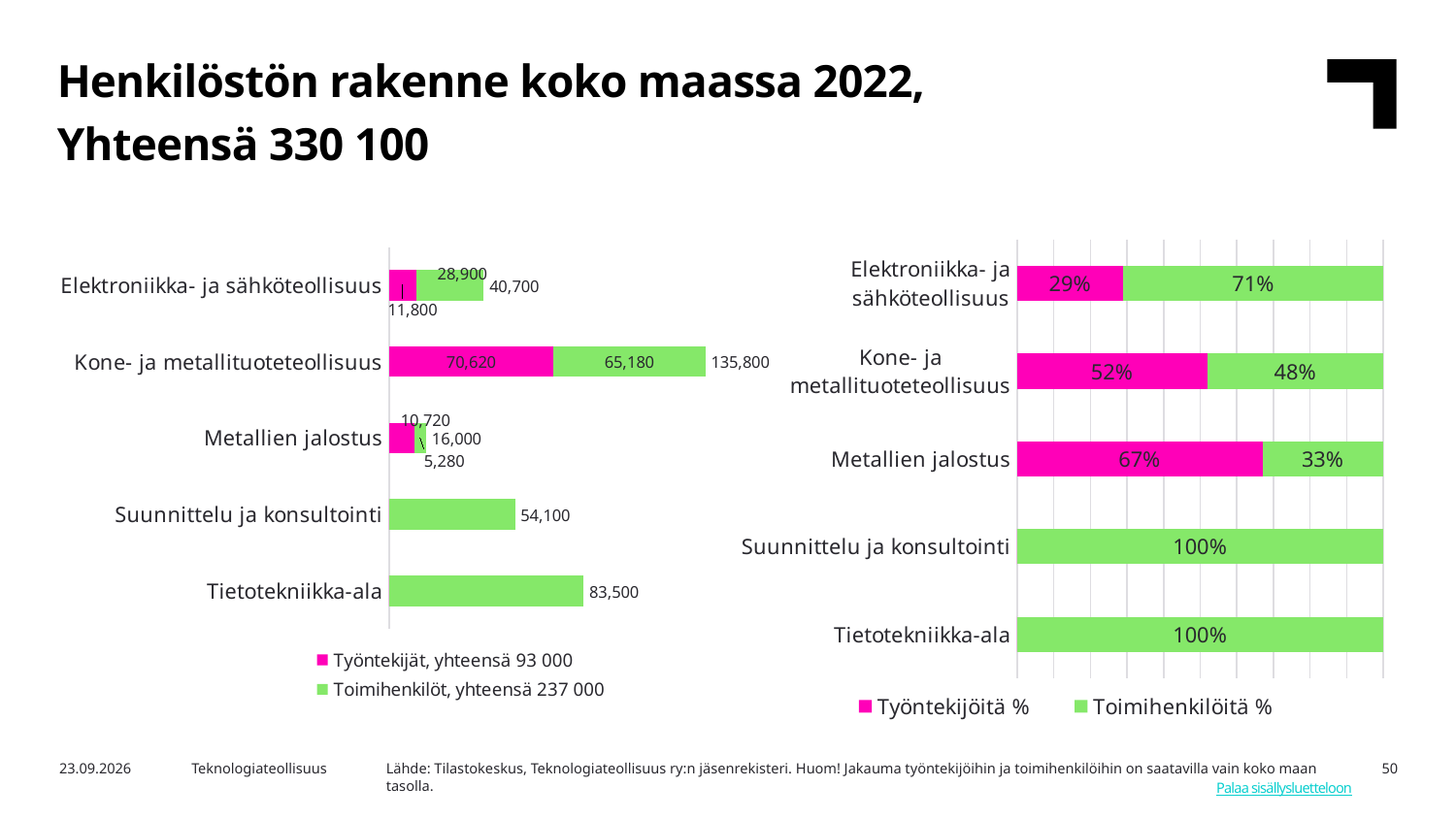
In the right chart, what is the Työntekijöitä % value for Metallien jalostus? 67% In the left chart, what is the total value shown for Kone- ja metallituoteteollisuus? 135,800 In the right chart, what is the Toimihenkilöitä % value for Elektroniikka- ja sähköteollisuus? 71% What type of chart is the right chart? Bar chart In the right chart, which is larger for Kone- ja metallituoteteollisuus: Työntekijöitä % or Toimihenkilöitä %? Työntekijöitä % In the left chart, what is the difference between the Työntekijät and Toimihenkilöt values for Kone- ja metallituoteteollisuus? 5,440 In the left chart, what is the Työntekijät value for Elektroniikka- ja sähköteollisuus? 11,800 In the left chart, what is the Toimihenkilöt value for Metallien jalostus? 5,280 In the left chart, how many series does the legend list? 2 In the left chart, what is the Toimihenkilöt value for Tietotekniikka-ala? 83,500 In the left chart, which category has the lowest total value? Metallien jalostus In the left chart, which category has the highest total value? Kone- ja metallituoteteollisuus